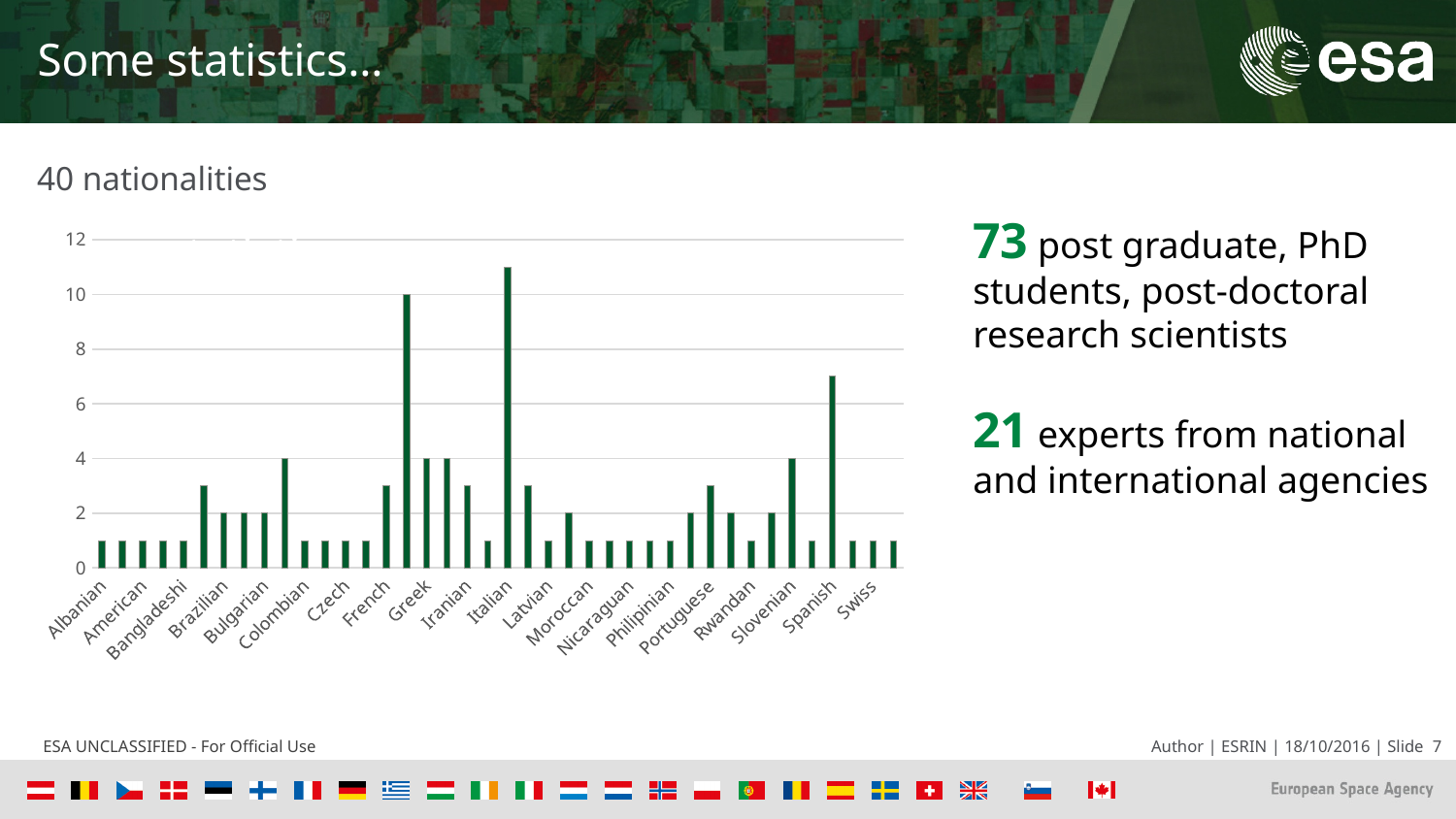
What kind of chart is shown on the slide? bar chart How many bars are plotted in the chart? 40 Is the value for Czech greater or less than 2? less Which nationality has the highest bar in the chart? Italian What is the title of the chart? 40 nationalities Which is larger, the value for Greek or the value for Spanish? Spanish Is the value for Spanish greater or less than 6? greater What is the value for Greek? 4